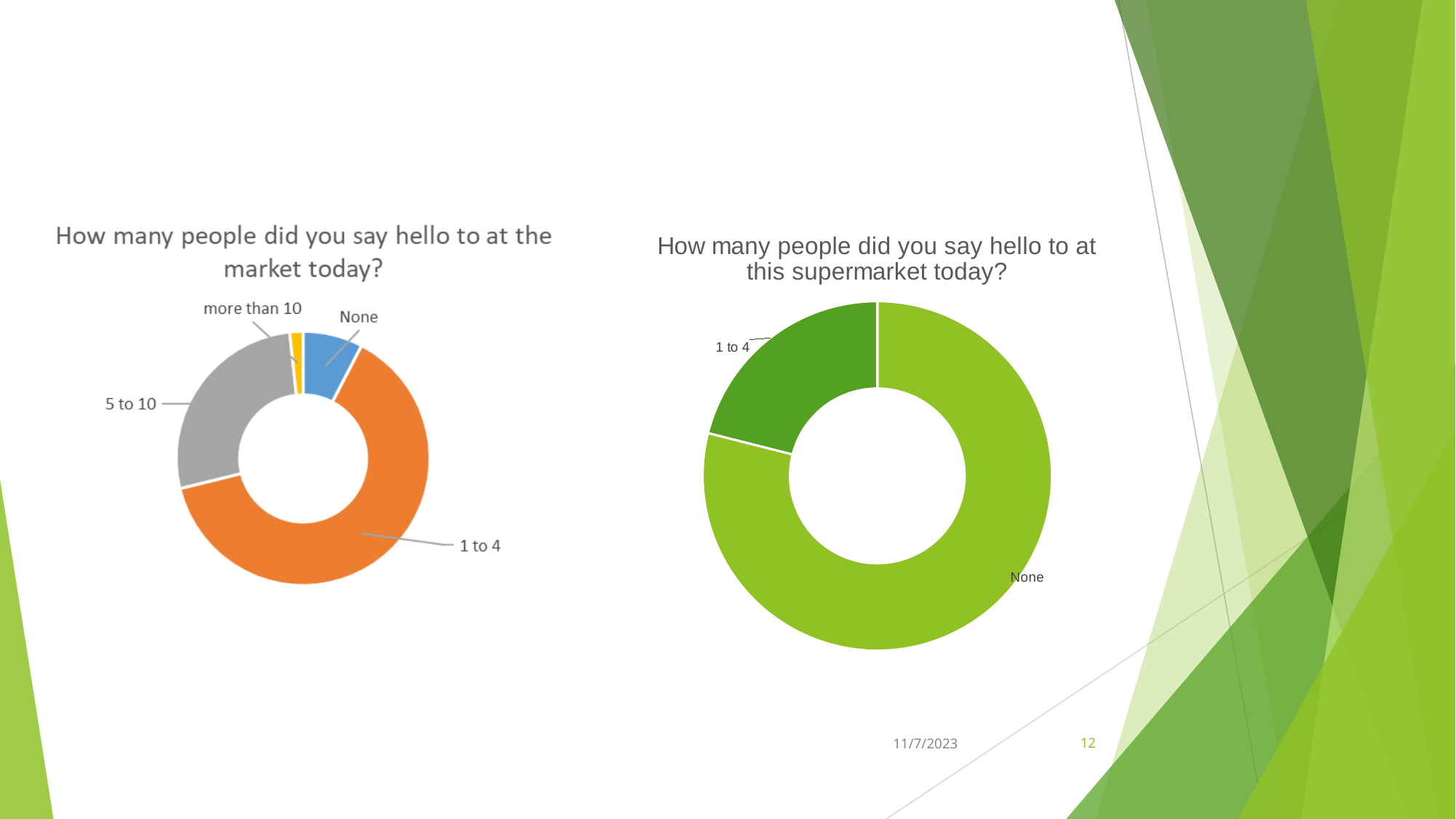
What type of chart is the right chart titled "How many people did you say hello to at this supermarket today?"? doughnut chart In the left chart (market), what colour is the "1 to 4" segment? orange How many categories are shown in the left chart (market)? 4 In the left chart (market), which category has the largest share? 1 to 4 In the left chart (market), which is larger: the share for "5 to 10" or the share for "None"? 5 to 10 What is the title of the right chart? How many people did you say hello to at this supermarket today? In the left chart (market), which category has the smallest share? more than 10 What type of chart is the left chart titled "How many people did you say hello to at the market today?"? doughnut chart In the right chart (supermarket), which category has the largest share? None In the right chart (supermarket), which category has the smallest share? 1 to 4 How many categories are shown in the right chart (supermarket)? 2 In the left chart (market), which is larger: the share for "None" or the share for "more than 10"? None